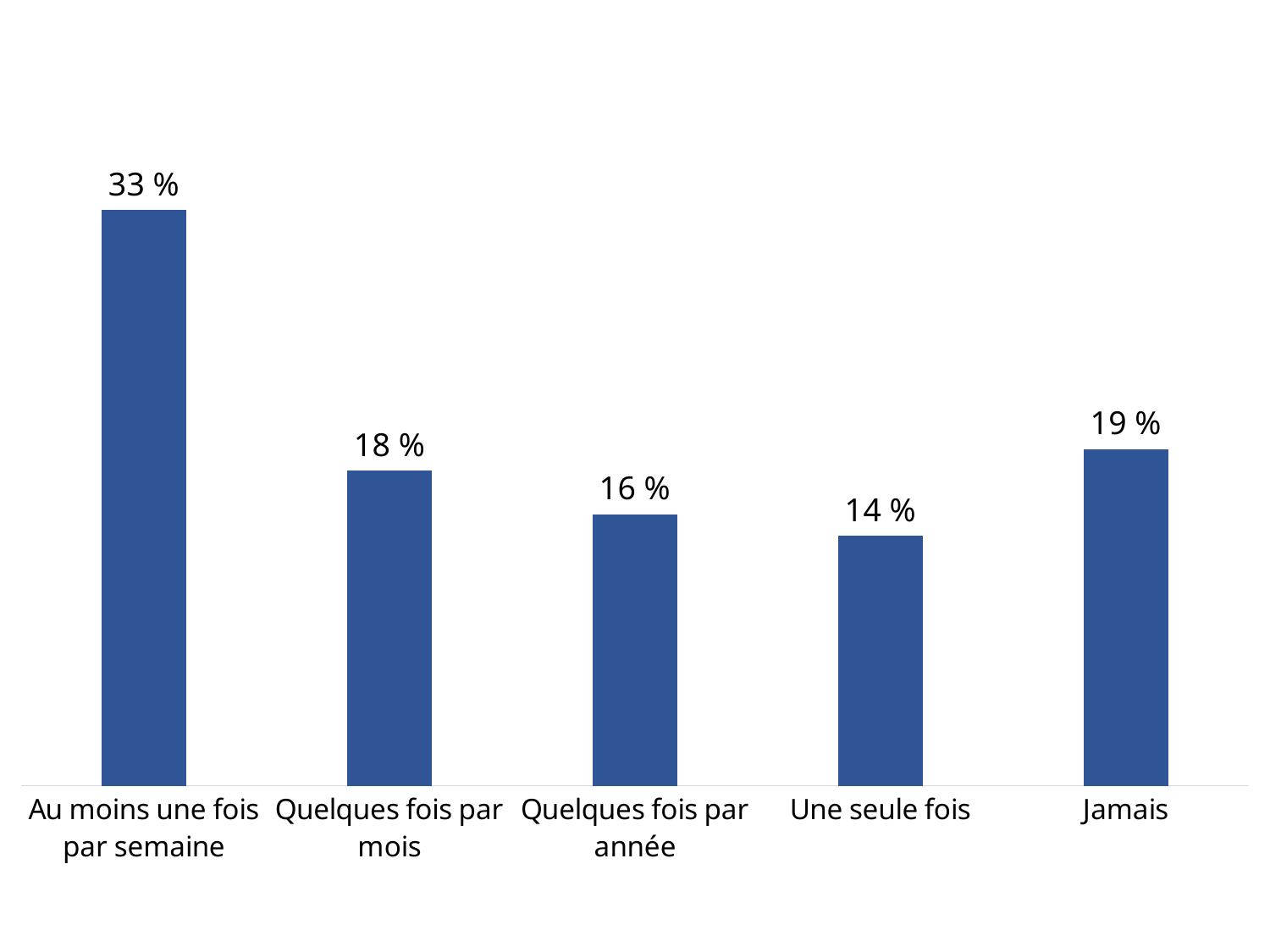
Which is larger, the value for "Jamais" or the value for "Quelques fois par mois"? Jamais What is the value for "Jamais"? 19 % What is the difference between the values for "Au moins une fois par semaine" and "Jamais"? 14 % What is the difference between the values for "Quelques fois par mois" and "Une seule fois"? 4 % Which category has the lowest value? Une seule fois What kind of chart is shown on the slide? Bar chart Which category has the highest value? Au moins une fois par semaine What is the value for "Quelques fois par année"? 16 % How many categories are shown on the chart? 5 What is the value for "Quelques fois par mois"? 18 % What is the value for "Une seule fois"? 14 % What is the value for "Au moins une fois par semaine"? 33 %